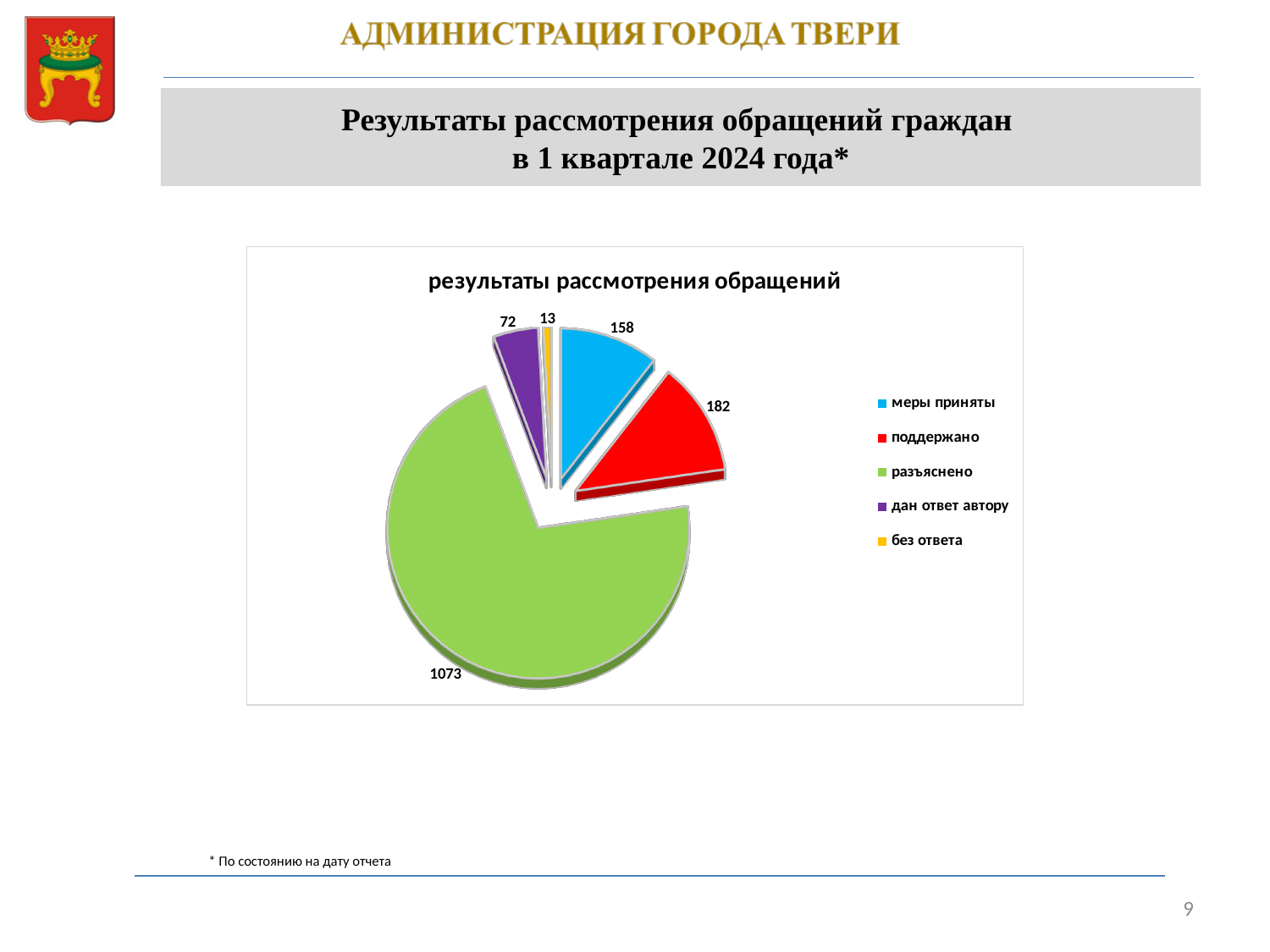
How many categories does the pie chart have? 5 What is the title of the chart? результаты рассмотрения обращений Which category has the smallest slice of the pie? без ответа What is the value for «поддержано»? 182 What is the value for «без ответа»? 13 What is the value for «разъяснено»? 1073 What is the total of all slices in the pie chart? 1498 Which category has the largest slice of the pie? разъяснено Which is larger: «дан ответ автору» or «без ответа»? дан ответ автору What kind of chart is shown on the slide? pie chart What is the difference between the values for «поддержано» and «меры приняты»? 24 What is the value for «меры приняты»? 158